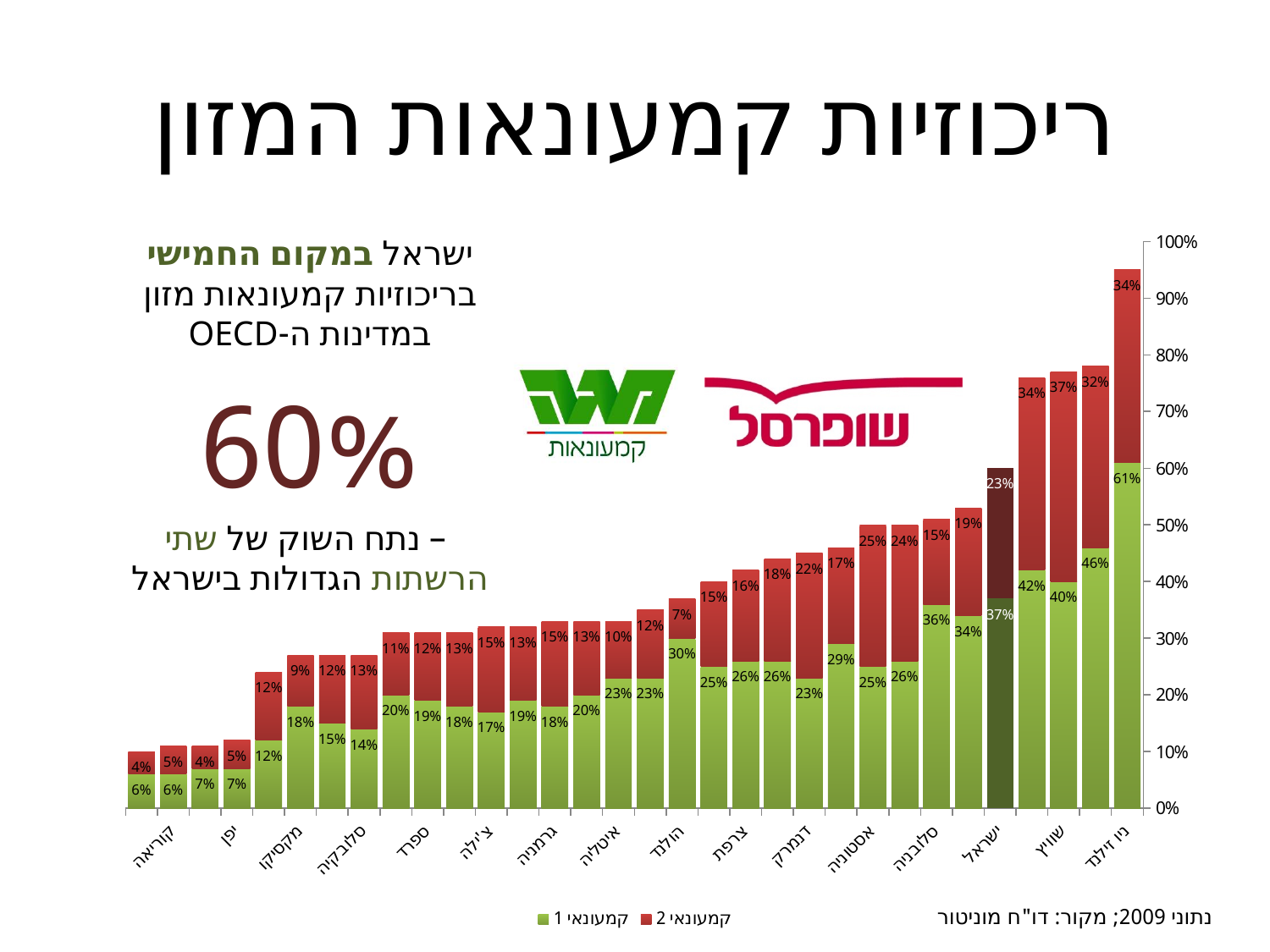
What is the value for קמעונאי 1 (retailer 1) for ישראל (Israel)? 37% What is the total of the stacked bar for ישראל (Israel)? 60% Do the combined values rise or fall from left to right along the x axis? Rise What is the difference between the קמעונאי 1 values for ניו זילנד (New Zealand) and ישראל (Israel)? 24% What is the total of the stacked bar for ניו זילנד (New Zealand)? 95% What is the value for קמעונאי 2 (retailer 2) for ישראל (Israel)? 23% Which country has the highest combined market share of the two retailers? ניו זילנד (New Zealand) What kind of chart is shown on the slide? Stacked bar chart For ישראל (Israel), which is larger: the value for קמעונאי 1 or קמעונאי 2? קמעונאי 1 What is the value for קמעונאי 1 (retailer 1) for ניו זילנד (New Zealand)? 61% How many series does the legend list? 2